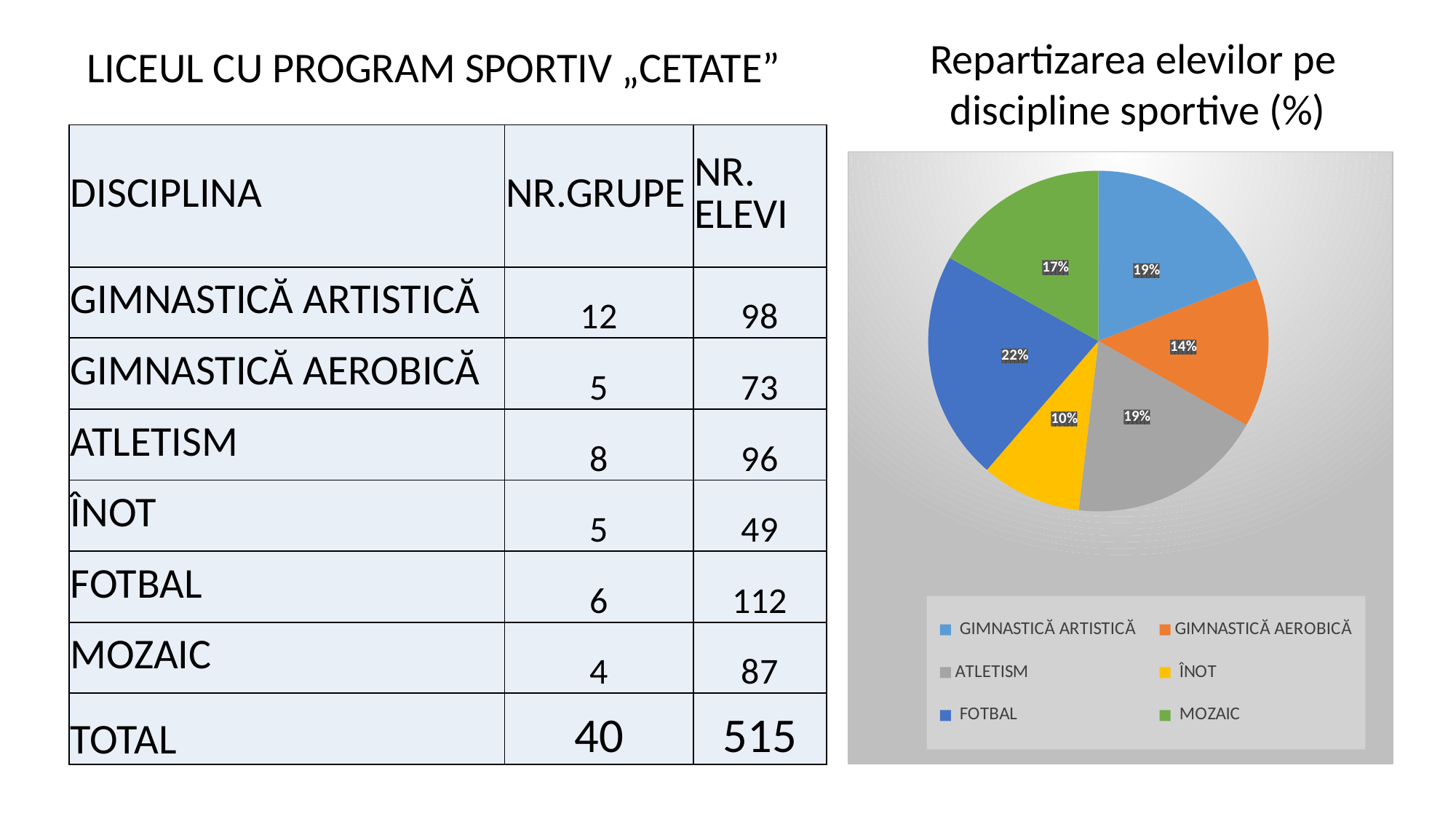
Which colour represents ATLETISM in the pie chart legend? gray What kind of chart is shown on the slide? pie chart What percentage does the pie chart show for ÎNOT? 10% Which discipline has the smallest slice in the pie chart? ÎNOT What is the title of the pie chart? Repartizarea elevilor pe discipline sportive (%) How many slices does the pie chart have? 6 What percentage does the pie chart show for MOZAIC? 17% Which discipline has the largest slice in the pie chart? FOTBAL In the pie chart, which is larger: the slice for FOTBAL or the slice for MOZAIC? FOTBAL By how many percentage points does the FOTBAL slice exceed the ÎNOT slice in the pie chart? 12 What percentage does the pie chart show for FOTBAL? 22% What percentage does the pie chart show for GIMNASTICĂ AEROBICĂ? 14%